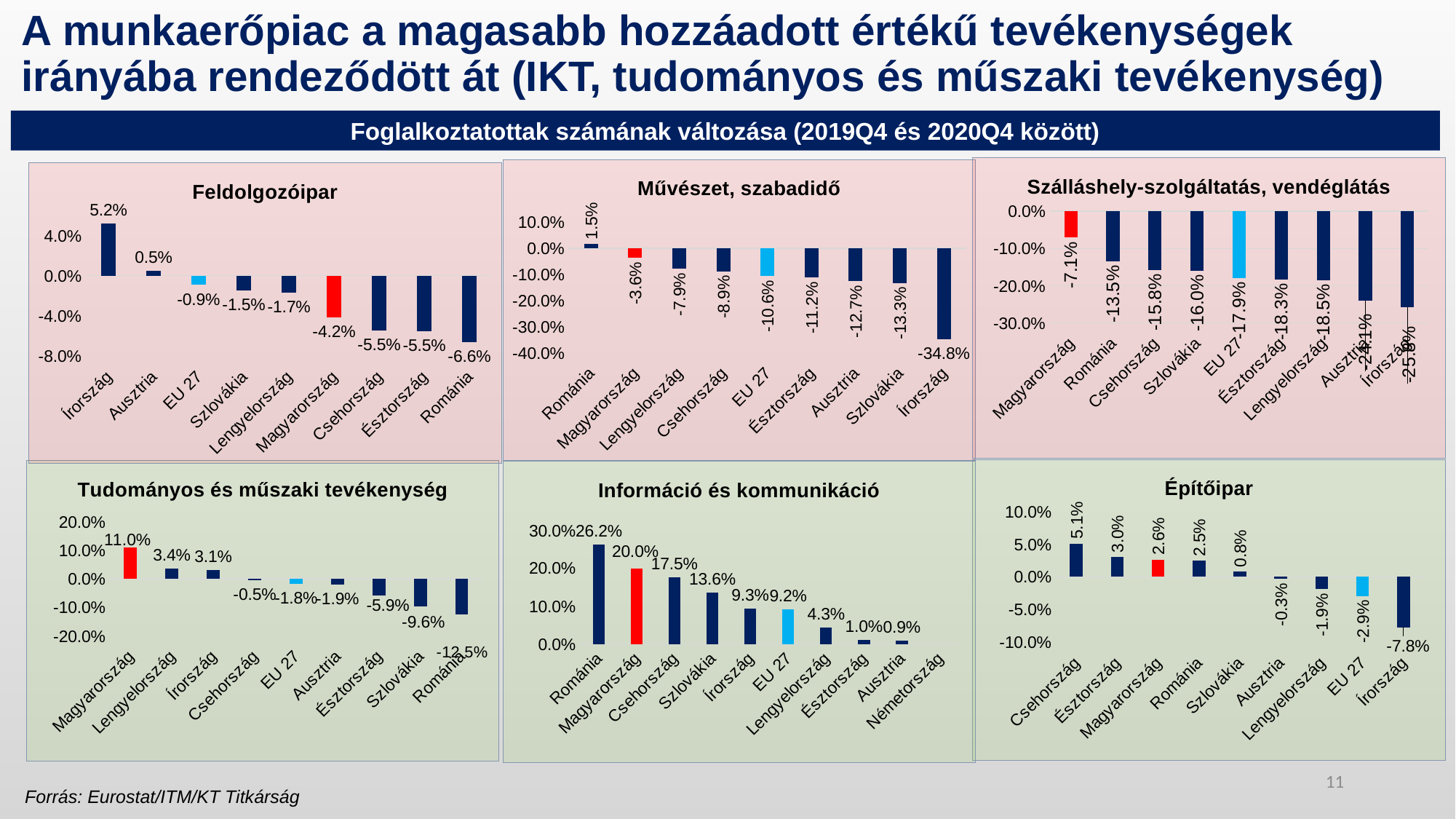
In the Építőipar chart, what is the value for Írország? -7.8% In the Információ és kommunikáció chart, which is larger, the value for Csehország or the value for Szlovákia? Csehország In the Művészet, szabadidő chart, what is the value for EU 27? -10.6% In the Szálláshely-szolgáltatás, vendéglátás chart, what is the value for Magyarország? -7.1% In the Tudományos és műszaki tevékenység chart, what is the value for Magyarország? 11.0% In the Információ és kommunikáció chart, what is the value for Románia? 26.2% In the Feldolgozóipar chart, which country has the highest value? Írország How many charts are shown on the slide? 6 In the Művészet, szabadidő chart, which country has the lowest value? Írország In the Feldolgozóipar chart, what is the value for Magyarország? -4.2% In the Szálláshely-szolgáltatás, vendéglátás chart, is the value for EU 27 greater or less than -10.0%? less In the Tudományos és műszaki tevékenység chart, what is the difference between the values for Lengyelország and Írország? 0.3%